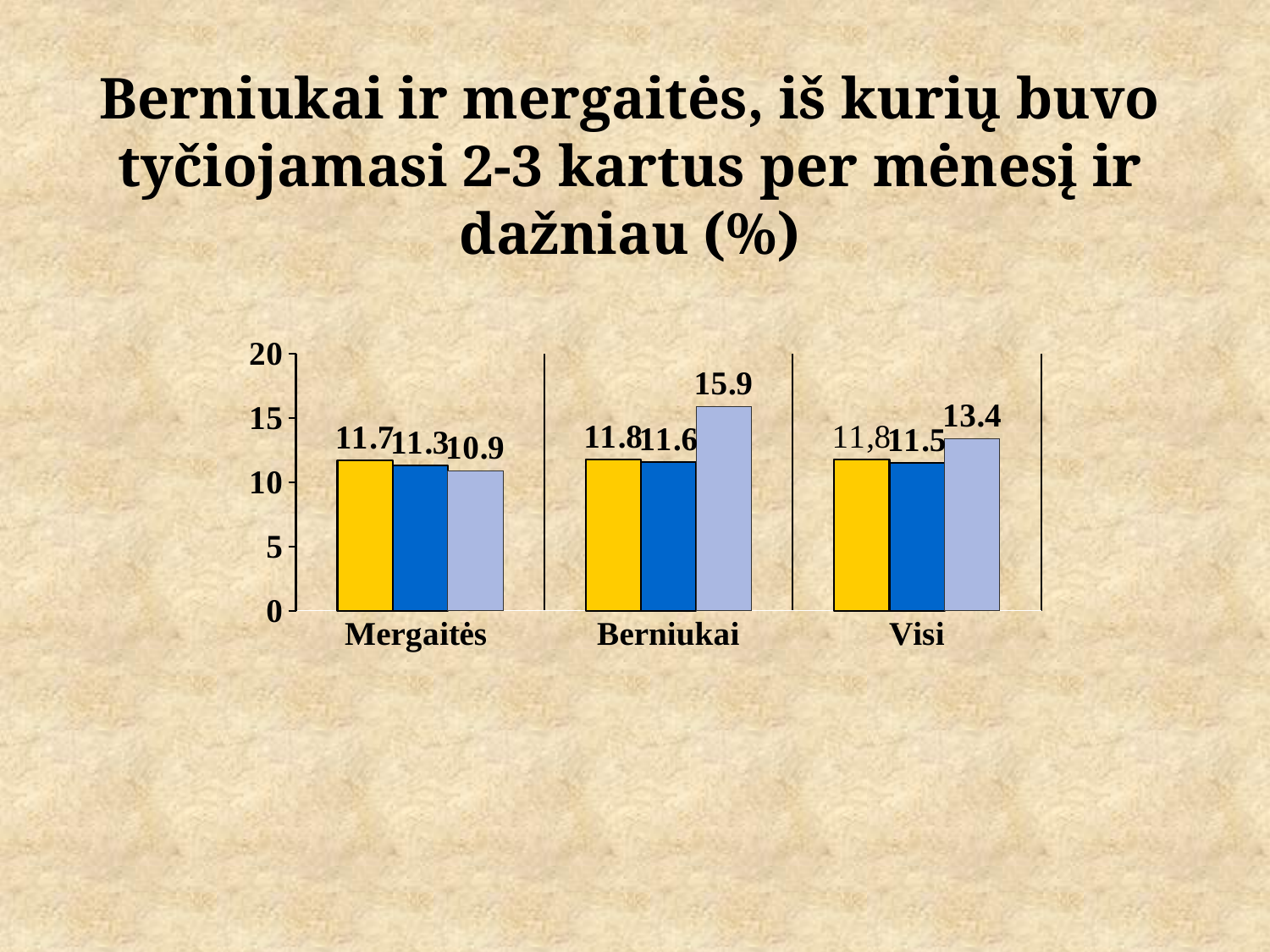
What is the value of the yellow bar for Mergaitės? 11.7 What is the value of the light blue bar for Berniukai? 15.9 Which is larger: the light blue bar for Berniukai or the light blue bar for Visi? Berniukai How many bars are shown for each category in the chart? 3 How many categories are shown on the x axis of the chart? 3 What is the difference between the light blue bar for Berniukai and the light blue bar for Mergaitės? 5 Which category has the highest single bar in the chart? Berniukai Which bar is the lowest in the chart? the light blue bar for Mergaitės (10.9) What kind of chart is shown on the slide? bar chart What is the value of the dark blue bar for Berniukai? 11.6 What is the value of the light blue bar for Visi? 13.4 Is the value of the light blue bar for Berniukai greater or less than 15? greater